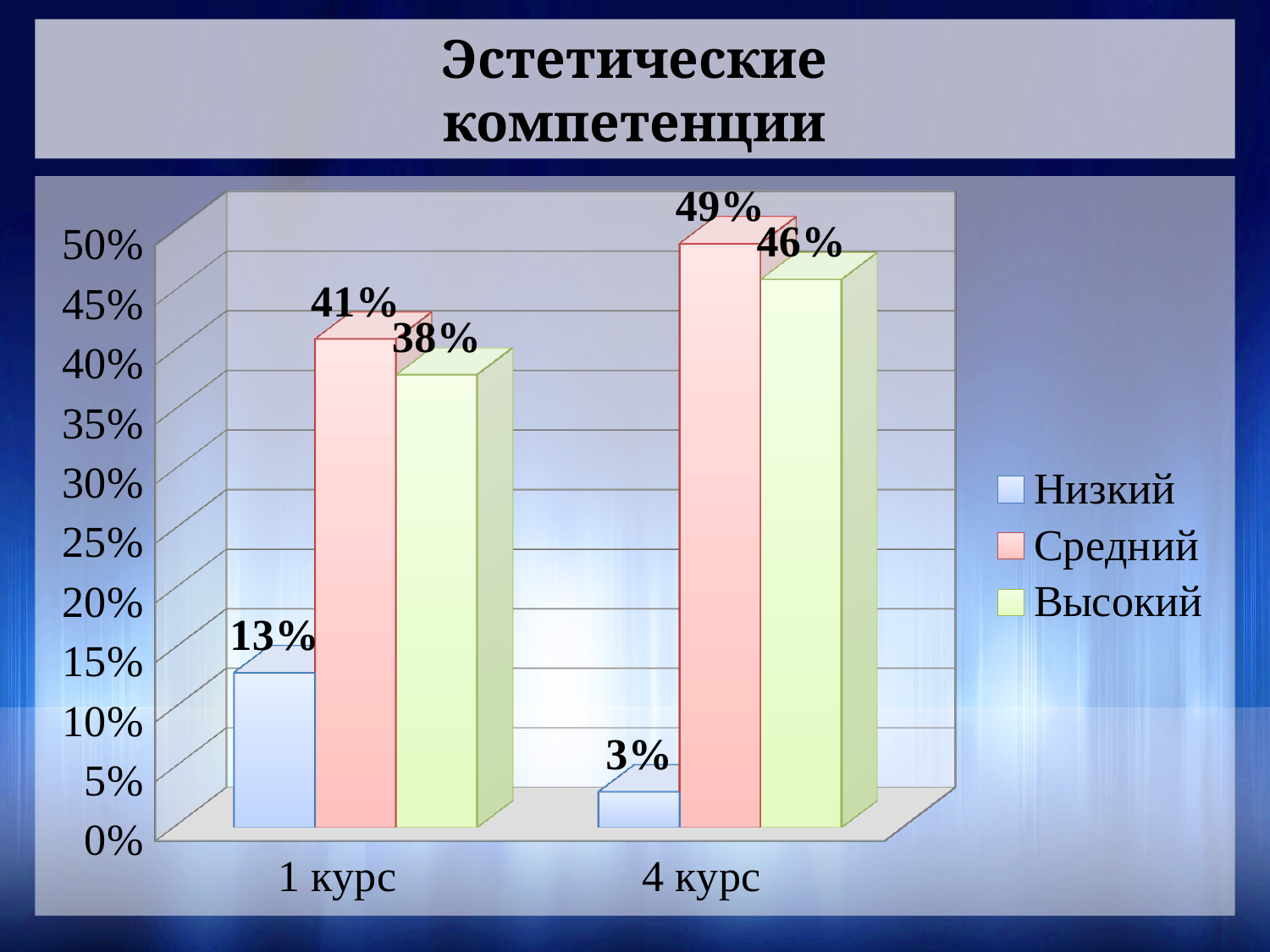
What is the value for Средний in 4 курс? 49% Which is larger: Высокий in 1 курс or Высокий in 4 курс? Высокий in 4 курс How many categories are shown on the x axis? 2 What kind of chart is shown on the slide? Bar chart What is the value for Низкий in 4 курс? 3% What is the difference between the Средний values for 4 курс and 1 курс? 8% Which series has the lowest value in 1 курс? Низкий What is the value for Низкий in 1 курс? 13% Which series has the highest value in 4 курс? Средний What is the value for Высокий in 1 курс? 38% What is the title of the slide? Эстетические компетенции How many series does the legend list? 3